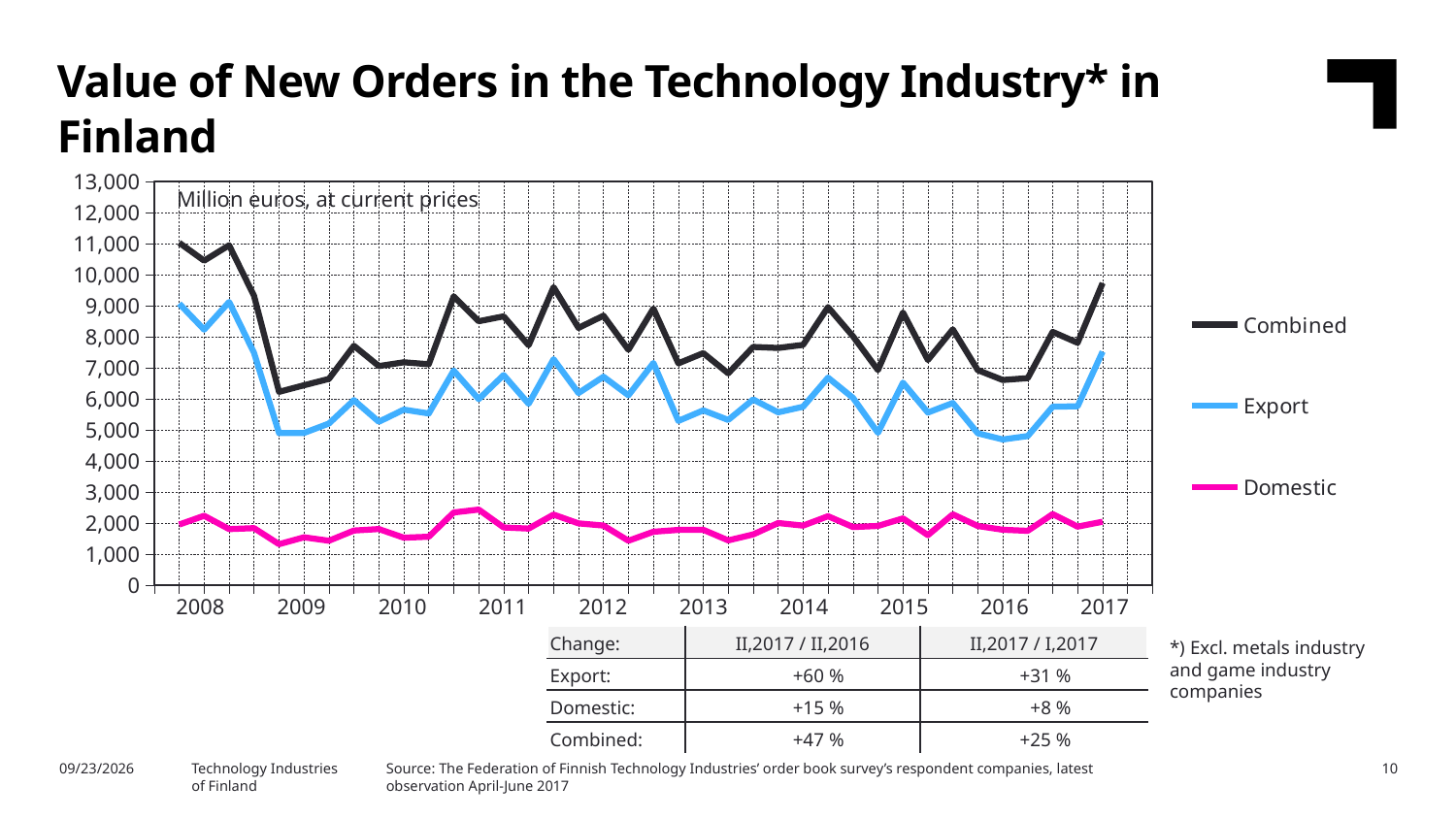
Is the value for Combined at the start of 2009 greater or less than 5,000? greater Which series has the highest values throughout the chart? Combined Which is larger at the start of 2012, the Export value or the Domestic value? Export Is the last plotted value for Export in 2017 greater or less than 8,000? less Is the value for Domestic at the start of 2008 greater or less than 3,000? less Does the Combined series rise or fall between the start of 2008 and the start of 2009? Fall How many years are labelled on the x axis? 10 What unit is stated inside the chart area? Million euros, at current prices What kind of chart is shown on the slide? Line chart Which series has the lowest values throughout the chart? Domestic How many series does the legend list? 3